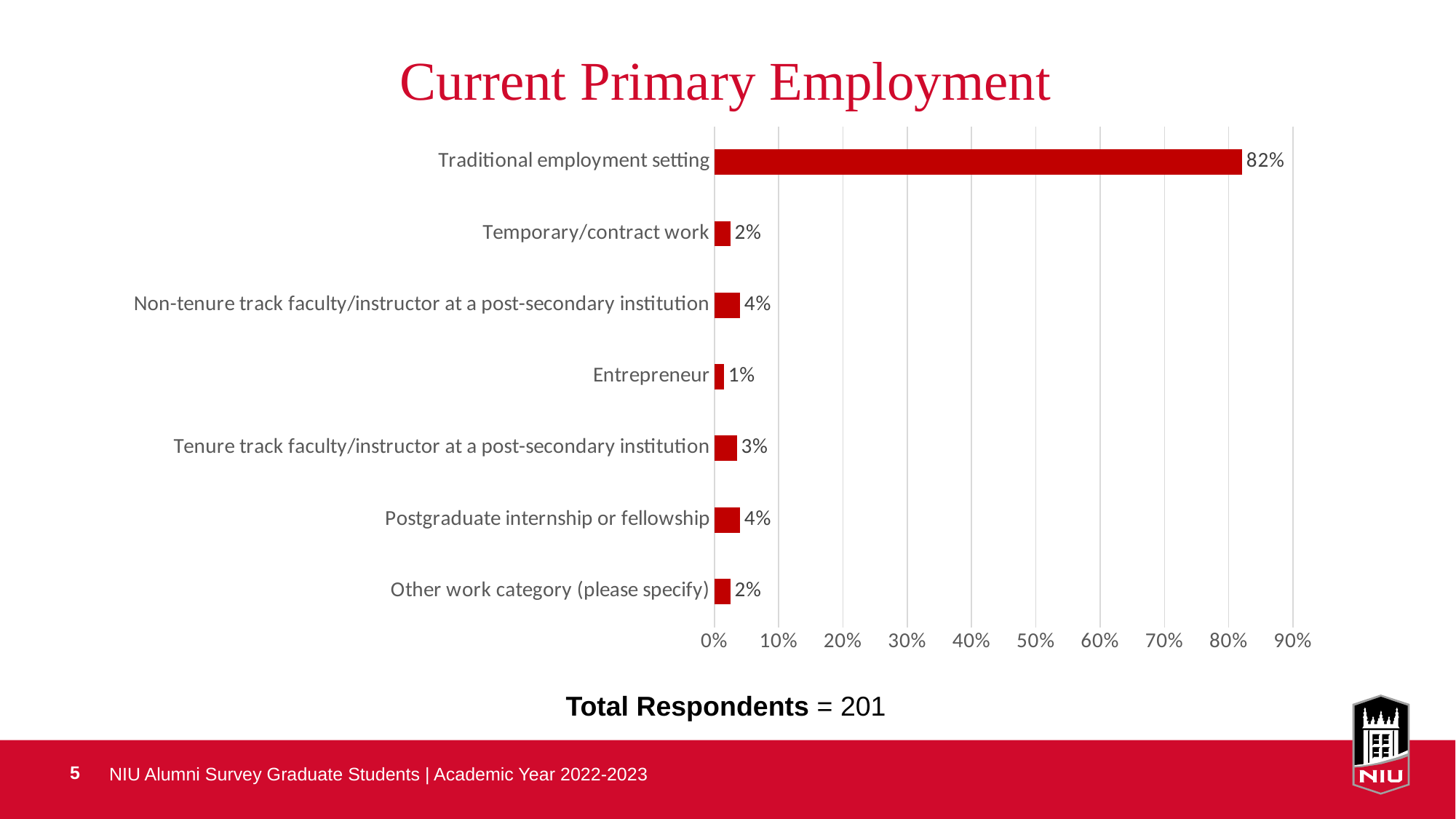
What is the title of the chart? Current Primary Employment Is the value for Traditional employment setting greater or less than 80%? greater What is the value for Entrepreneur? 1% What is the value for Postgraduate internship or fellowship? 4% Which is larger, Temporary/contract work or Tenure track faculty/instructor at a post-secondary institution? Tenure track faculty/instructor at a post-secondary institution What kind of chart is shown on the slide? Bar chart What percentage of respondents are in a traditional employment setting? 82% How many categories are shown in the chart? 7 Which category has the highest value? Traditional employment setting Which category has the lowest value? Entrepreneur What is the difference between Traditional employment setting and Non-tenure track faculty/instructor at a post-secondary institution? 78% What is the value for Tenure track faculty/instructor at a post-secondary institution? 3%